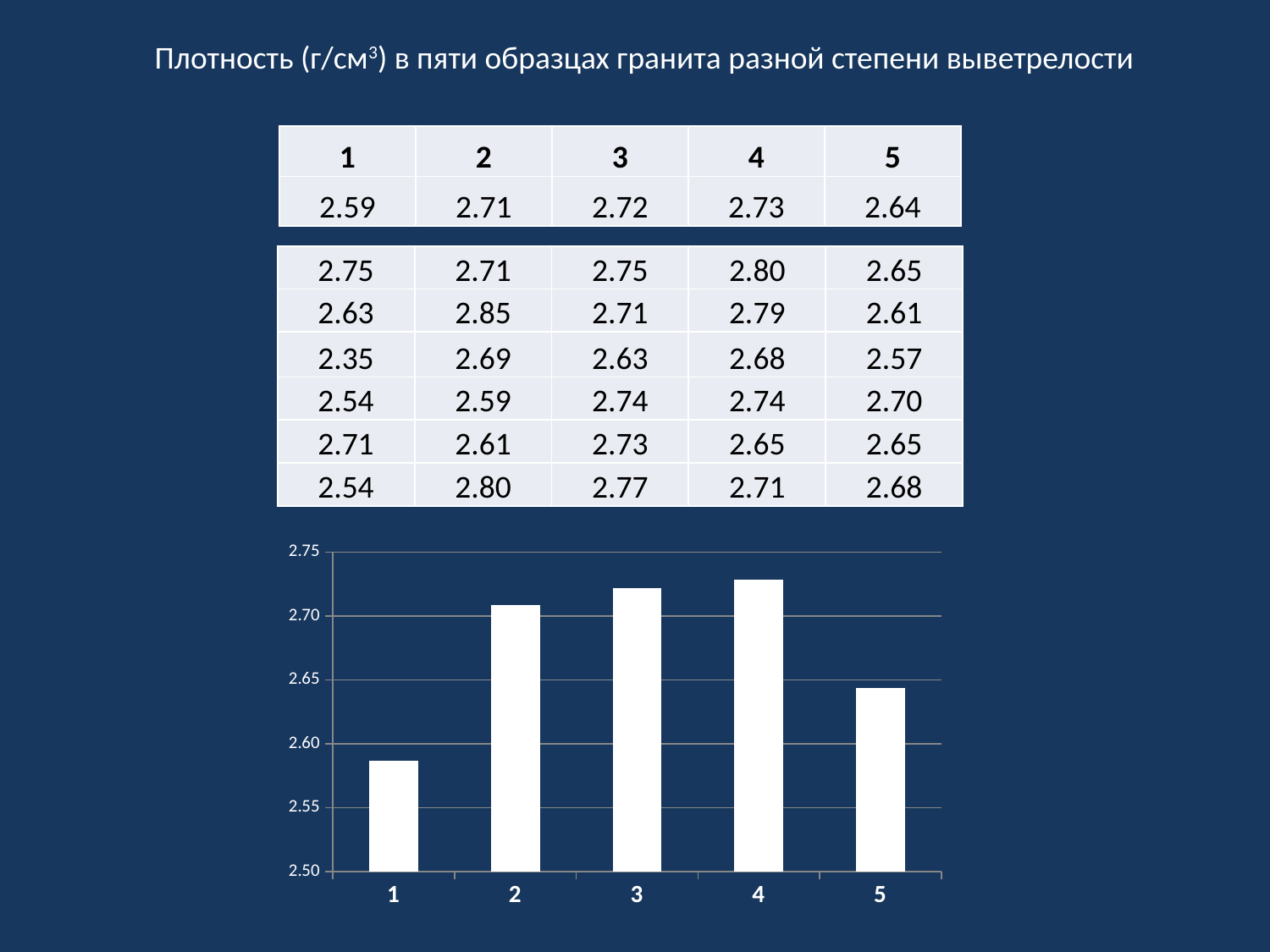
Which is larger, the value for sample 2 or the value for sample 5? sample 2 Is the value for sample 5 greater or less than 2.60? greater Is the value for sample 3 greater or less than 2.70? greater Is the value for sample 1 greater or less than 2.55? greater Do the bars rise or fall from sample 1 to sample 4? rise Which is larger, the value for sample 1 or the value for sample 5? sample 5 What kind of chart is shown on the slide? bar chart How many samples (bars) are plotted in the chart? 5 What is the highest value shown on the chart's vertical axis? 2.75 Which sample has the lowest bar in the chart? 1